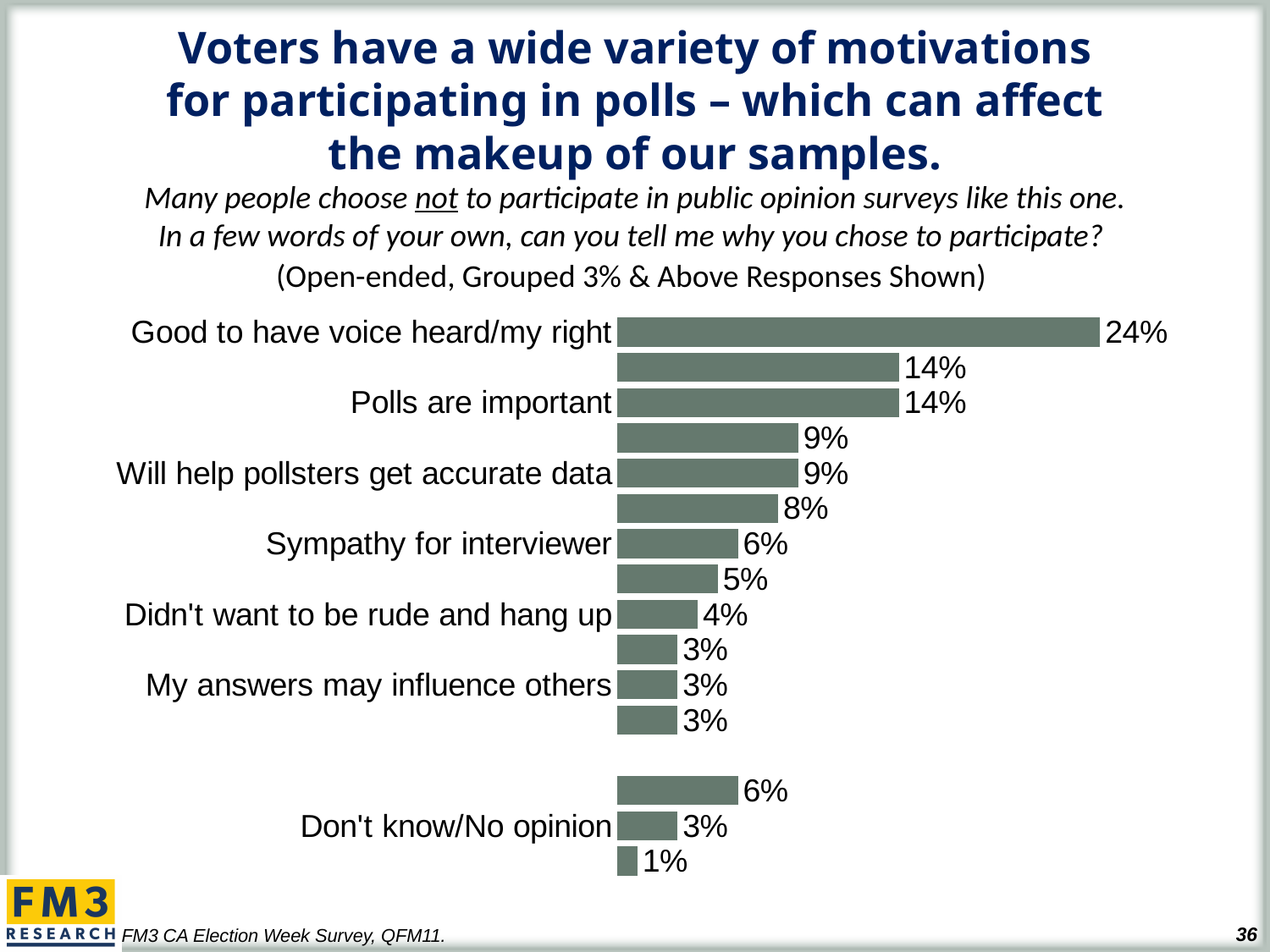
What kind of chart is shown on the slide? Bar chart What percentage is shown for 'Will help pollsters get accurate data'? 9% What value is shown for 'My answers may influence others'? 3% Which labeled response has the highest percentage? Good to have voice heard/my right What percentage of respondents said 'Didn't want to be rude and hang up'? 4% What value is shown for 'Polls are important'? 14% What value is shown for 'Sympathy for interviewer'? 6% Which is larger: the value for 'Polls are important' or for 'Sympathy for interviewer'? Polls are important How many bars are plotted in the chart? 15 What percentage is shown for 'Don't know/No opinion'? 3% What is the difference in percentage points between 'Good to have voice heard/my right' and 'Polls are important'? 10 percentage points What percentage of respondents said 'Good to have voice heard/my right'? 24%